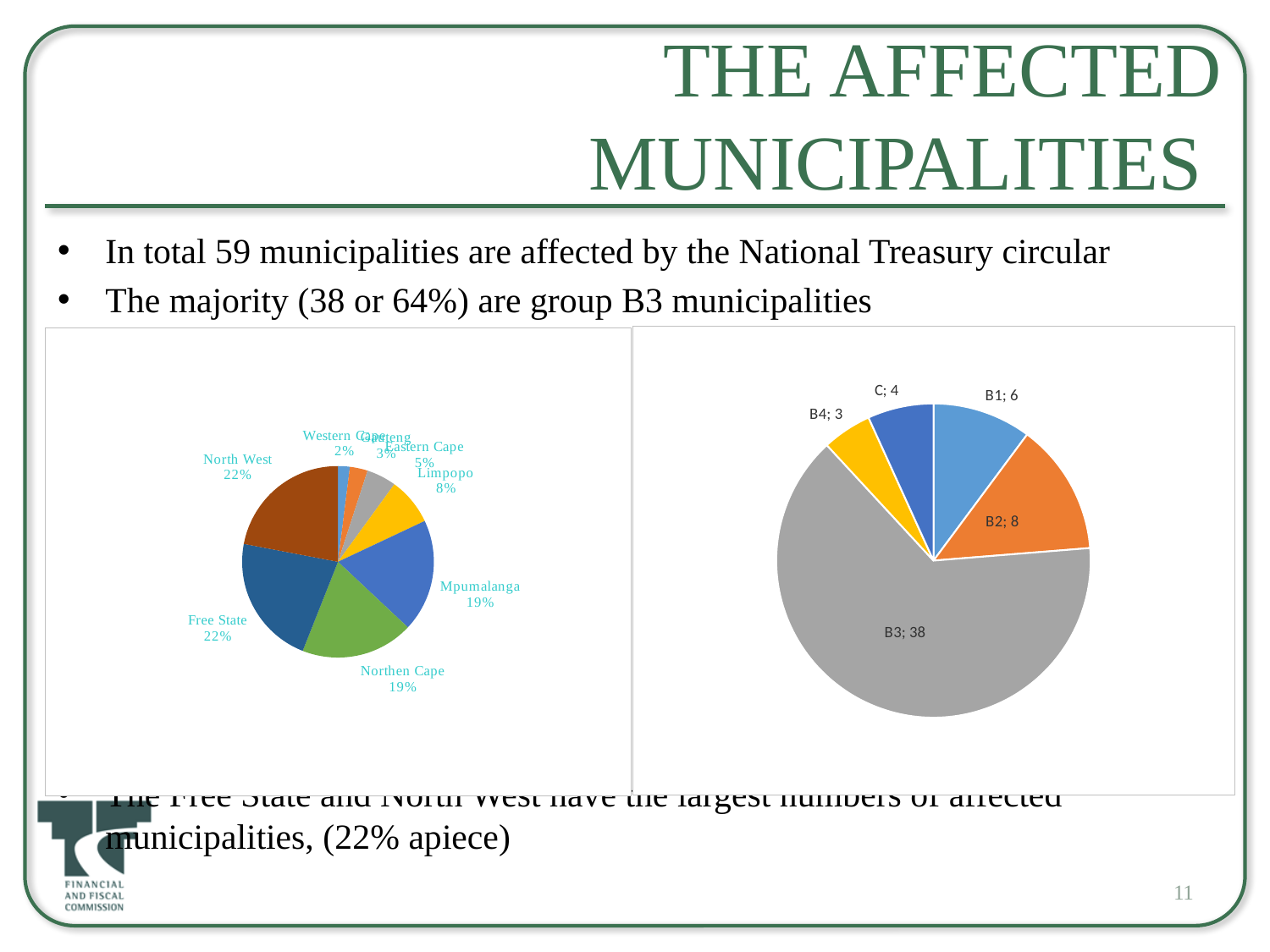
In the left pie chart, what share does Mpumalanga have? 19% In the left pie chart, what share does Limpopo have? 8% How many slices does the right pie chart have? 5 In the right pie chart, which category has the largest value? B3 In the right pie chart, what is the difference between the values for B1 and C? 2 In the right pie chart, what is the value for B2? 8 In the left pie chart, which is larger, the share for Eastern Cape or the share for Gauteng? Eastern Cape In the right pie chart, what is the value for B3? 38 What type of chart is the left chart on the slide? pie chart How many slices does the left pie chart have? 8 In the left pie chart, which province has the smallest share? Western Cape In the right pie chart, which category has the smallest value? B4